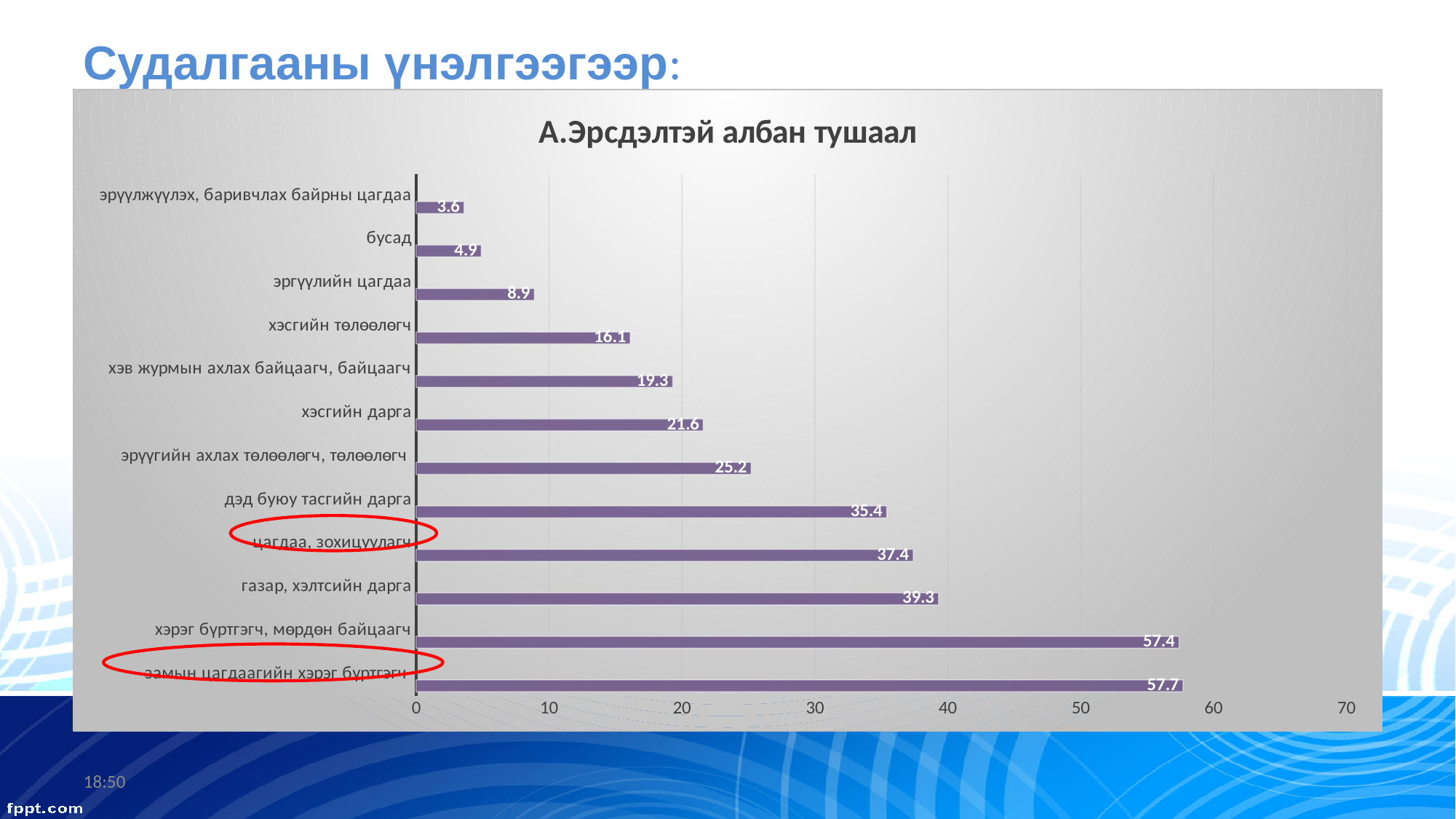
What is the value for 'хэсгийн дарга'? 21.6 What is the value for 'эргүүлийн цагдаа'? 8.9 Which category has the lowest value? эрүүлжүүлэх, баривчлах байрны цагдаа What is the value for 'газар, хэлтсийн дарга'? 39.3 Which is larger: the value for 'хэв журмын ахлах байцаагч, байцаагч' or the value for 'эрүүгийн ахлах төлөөлөгч, төлөөлөгч'? эрүүгийн ахлах төлөөлөгч, төлөөлөгч What type of chart is shown on the slide? bar chart What is the difference between the values for 'хэрэг бүртгэгч, мөрдөн байцаагч' and 'дэд буюу тасгийн дарга'? 22 What is the difference between the values for 'бусад' and 'эрүүлжүүлэх, баривчлах байрны цагдаа'? 1.3 Which category has the highest value? замын цагдаагийн хэрэг бүртгэгч What is the title of the chart? А.Эрсдэлтэй албан тушаал Is the value for 'цагдаа, зохицуулагч' greater or less than 30? greater How many categories are plotted in the chart? 12